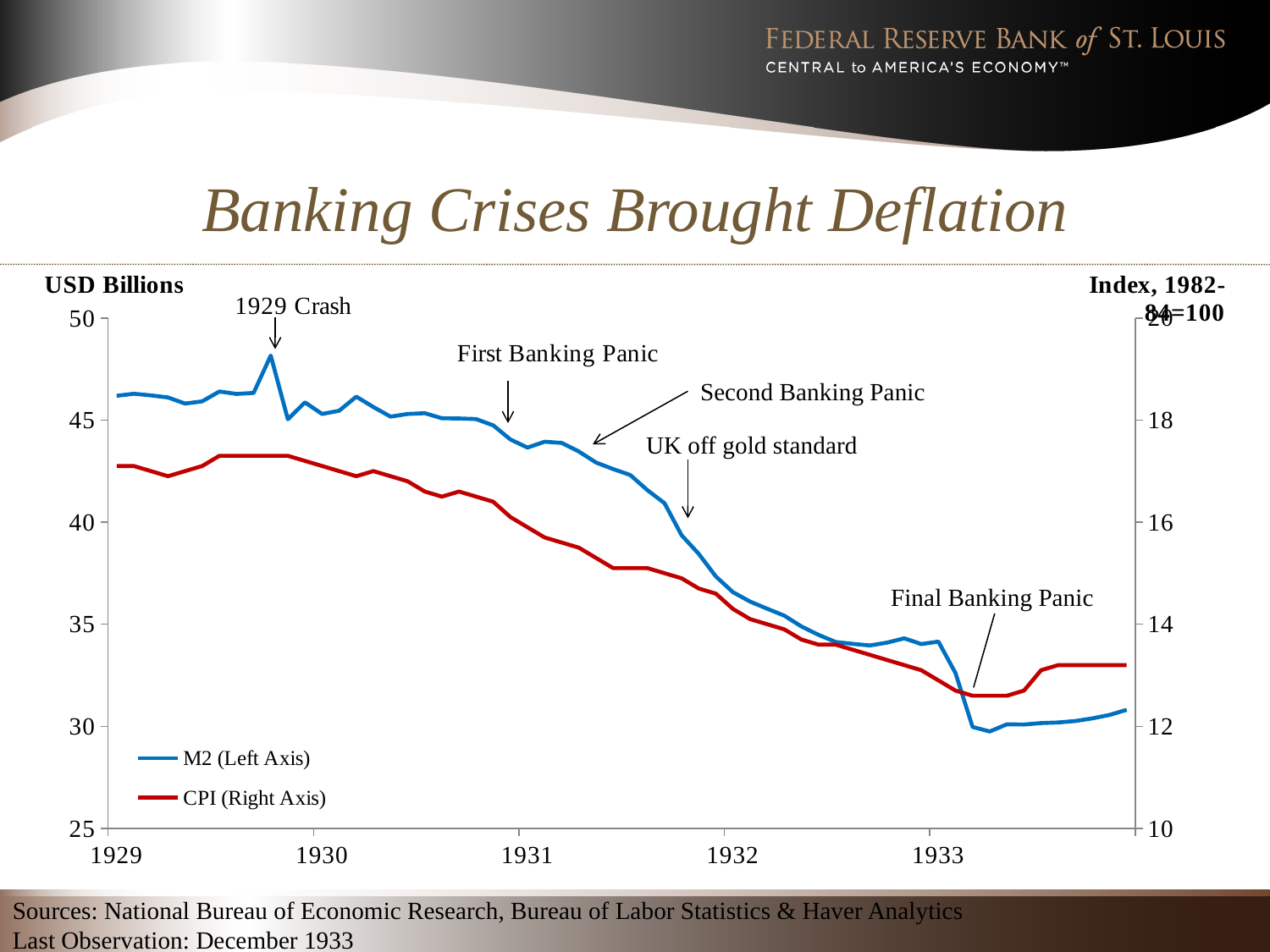
Does the CPI series rise or fall overall from 1929 to the end of 1933? fall Is the value of M2 at the start of 1929 greater or less than 45? greater Is the value of M2 at the end of 1933 greater or less than 35? less Is the value of CPI at the start of 1932 greater or less than 16? less How many series does the legend list? 2 Does the M2 series rise or fall overall from 1929 to the end of 1933? fall What kind of chart is shown on the slide? line chart What is the title of the chart? Banking Crises Brought Deflation Which series is plotted on the right axis according to the legend? CPI (Right Axis)